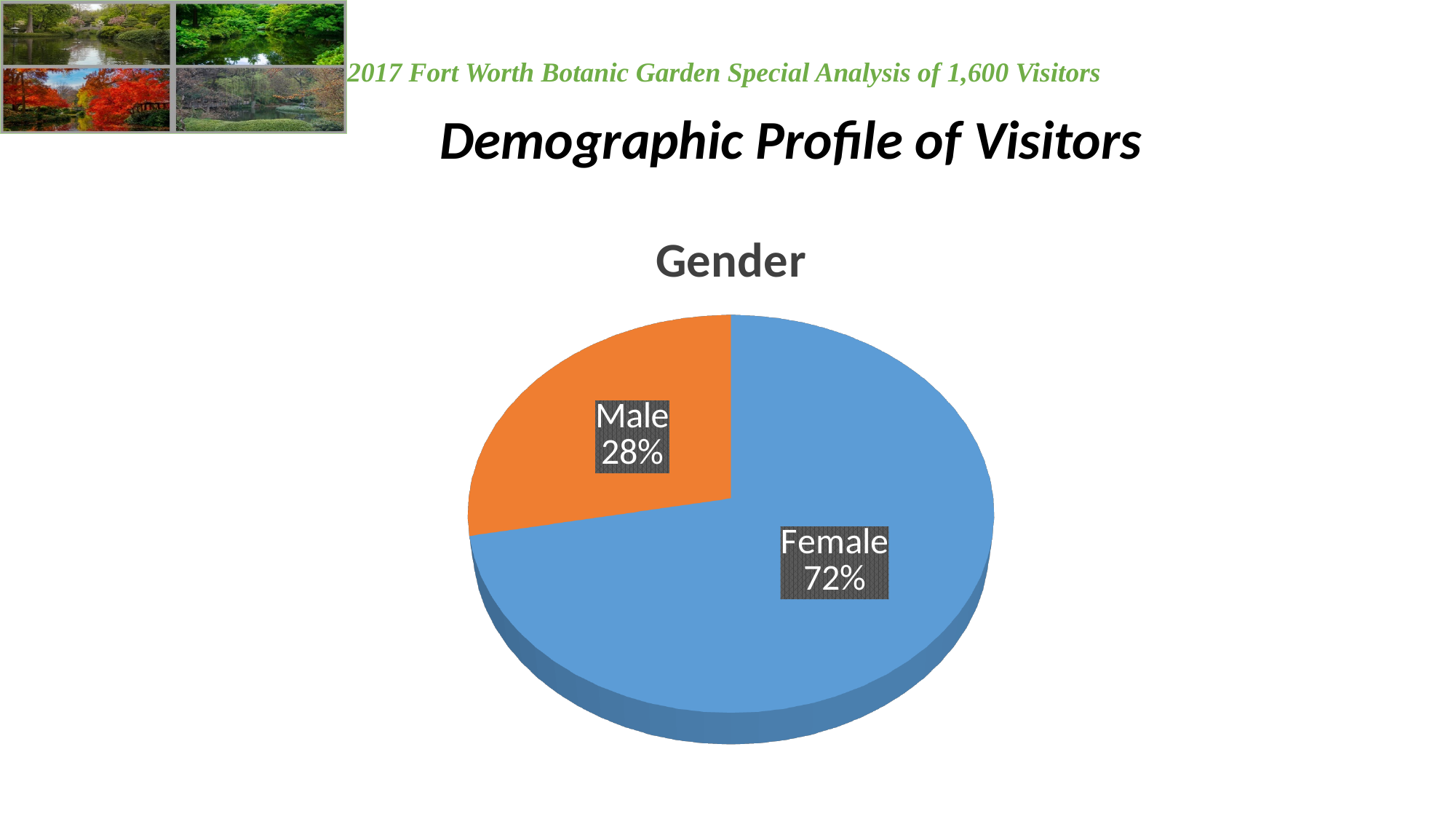
What is the difference in percentage points between the Female and Male shares? 44 What is the title of the chart? Gender How many slices does the Gender pie chart have? 2 Which gender has the smallest share in the pie chart? Male Which gender has the largest share in the pie chart? Female What percentage of visitors are Male according to the Gender pie chart? 28% What percentage of visitors are Female according to the Gender pie chart? 72% What kind of chart is shown on the slide? Pie chart What colour is the Male slice of the pie chart? Orange What share of the pie does the Female slice represent? 72% Which is larger, the Male share or the Female share? Female